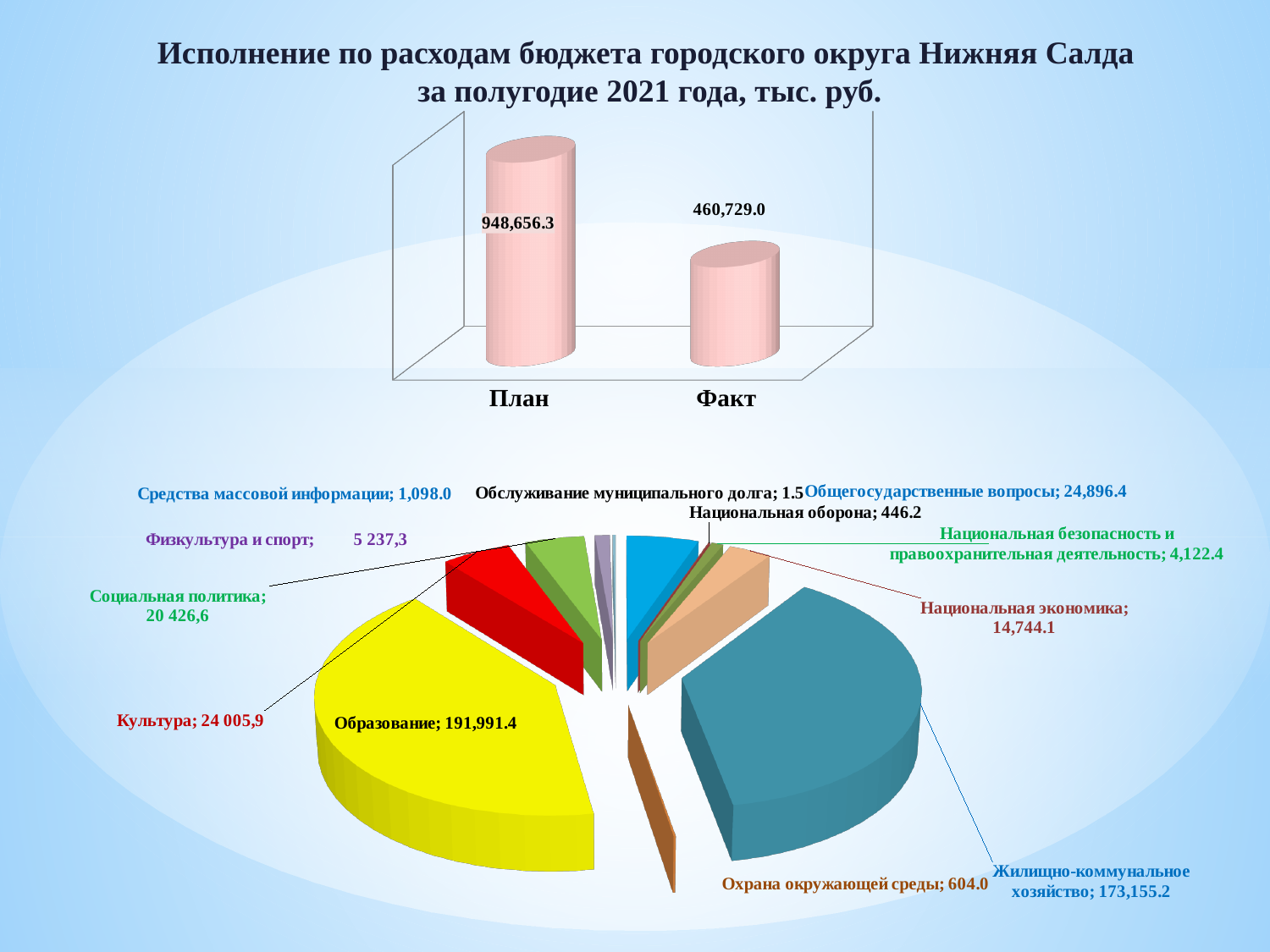
In the bottom pie chart, which category has the largest slice? Образование In the bottom pie chart, which is larger, Национальная экономика or Общегосударственные вопросы? Общегосударственные вопросы In the top bar chart, what is the value for Факт? 460,729.0 In the top bar chart, what is the difference between План and Факт? 487,927.3 In the top bar chart, which is larger, План or Факт? План What kind of chart is the top chart on the slide? Bar chart In the bottom pie chart, what is the value for Образование? 191,991.4 What kind of chart is the bottom chart on the slide? Pie chart In the top bar chart, what is the value for План? 948,656.3 In the bottom pie chart, which category has the smallest value? Обслуживание муниципального долга In the bottom pie chart, how many categories are shown? 12 In the bottom pie chart, what is the value for Жилищно-коммунальное хозяйство? 173,155.2